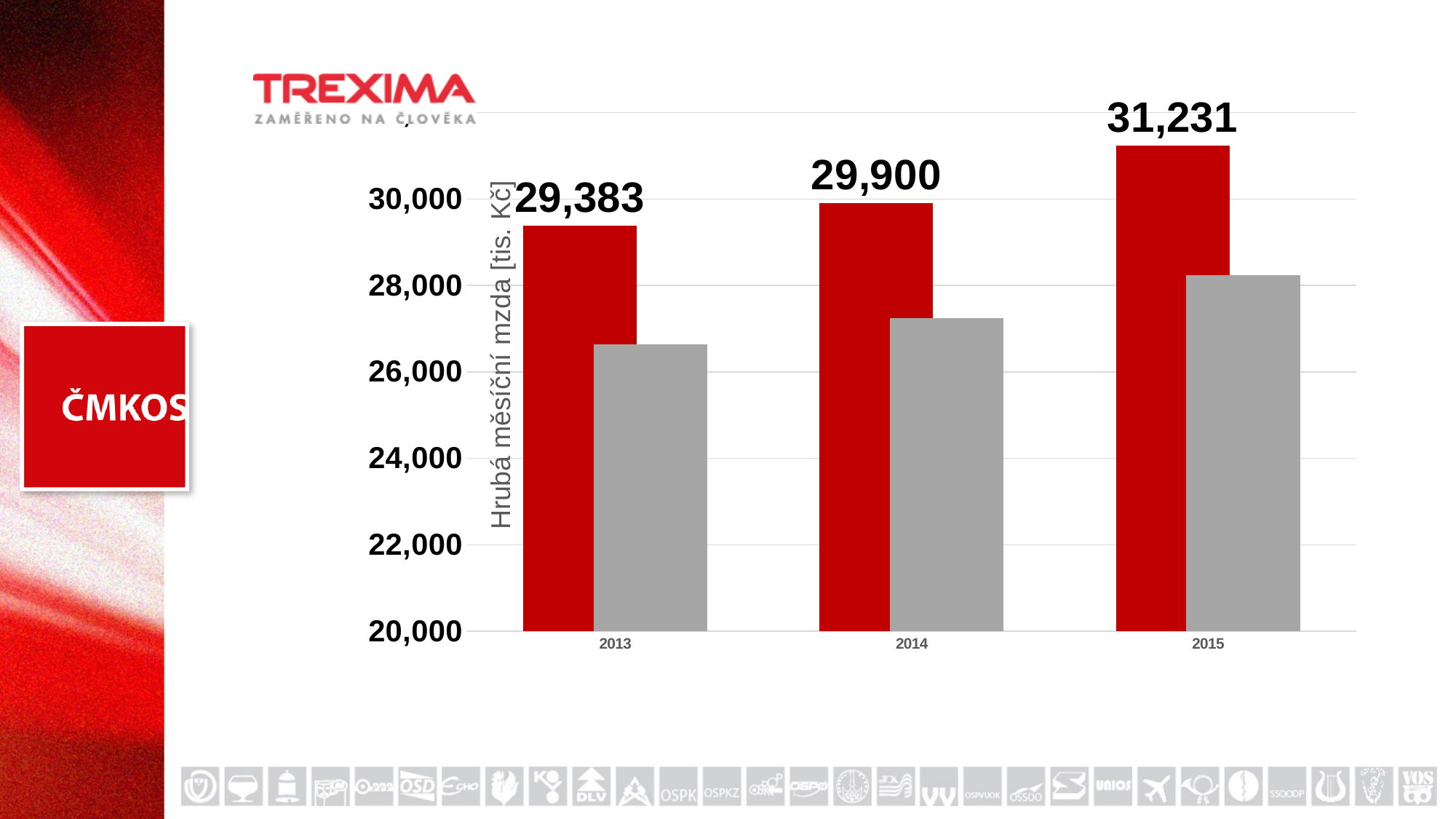
What is the value of the red bar for 2013? 29,383 What is the difference between the red bar values for 2015 and 2013? 1,848 How many years are shown on the x axis? 3 Do the red bar values rise or fall from 2013 to 2015? rise What is the difference between the red bar values for 2014 and 2013? 517 Is the value of the grey bar for 2013 greater or less than 28,000? less What is the value of the red bar for 2014? 29,900 Which year has the highest red bar value? 2015 In 2014, which bar is taller, the red bar or the grey bar? the red bar What is the value of the red bar for 2015? 31,231 Is the value of the grey bar for 2014 greater or less than 26,000? greater Which year has the lowest red bar value? 2013